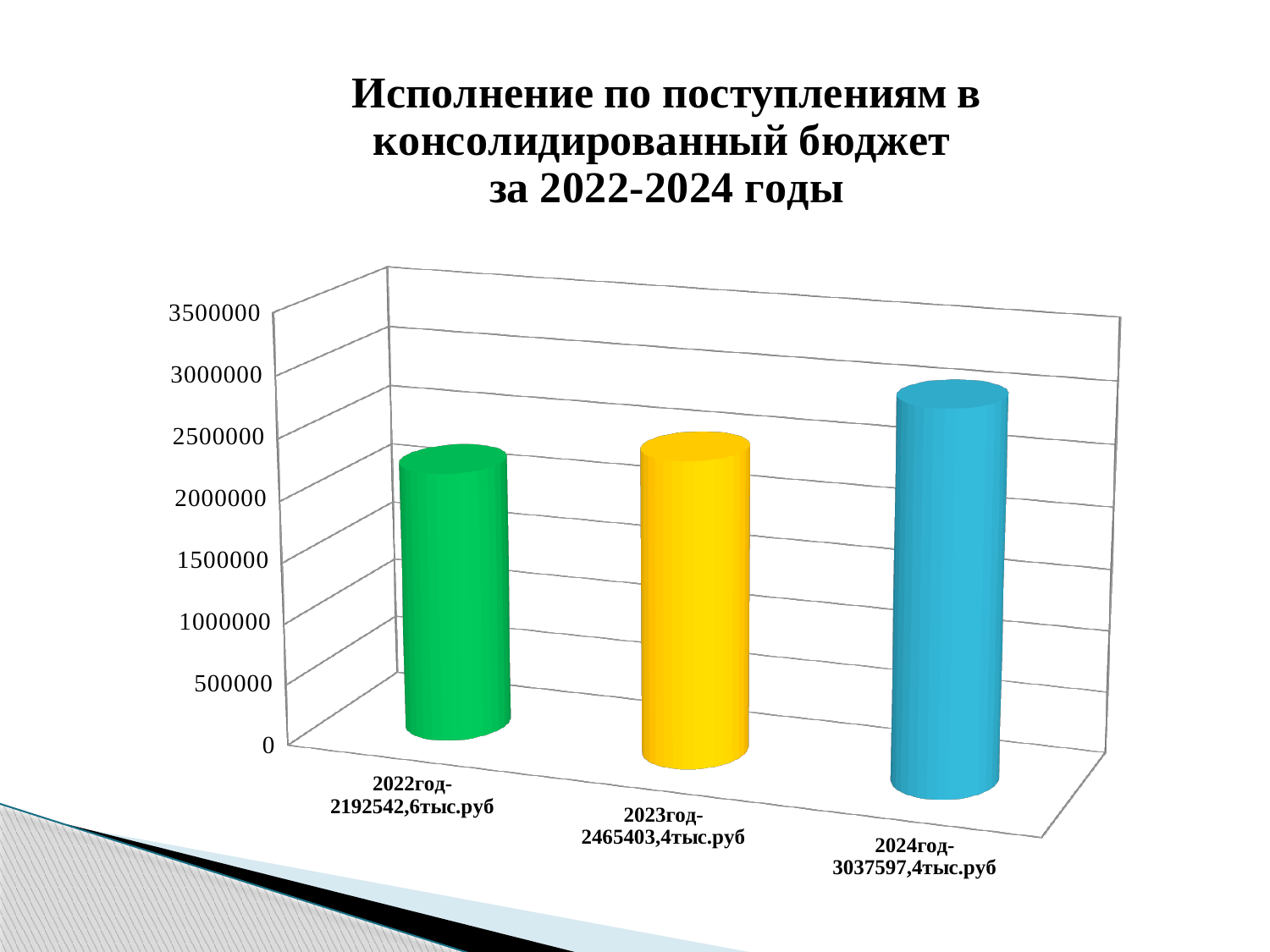
Is the value for 2024 год greater or less than 2500000? greater What is the difference between the values for 2023 год and 2022 год? 272860,8 тыс.руб What is the value for 2022 год? 2192542,6 тыс.руб How many years are shown in the chart? 3 Which year has the highest value? 2024 год Do the values rise or fall from 2022 to 2024? rise What is the value for 2024 год? 3037597,4 тыс.руб What is the difference between the values for 2024 год and 2023 год? 572194,0 тыс.руб Which year has the lowest value? 2022 год What is the value for 2023 год? 2465403,4 тыс.руб What kind of chart is shown on the slide? bar chart Which is larger, the value for 2023 год or the value for 2022 год? 2023 год